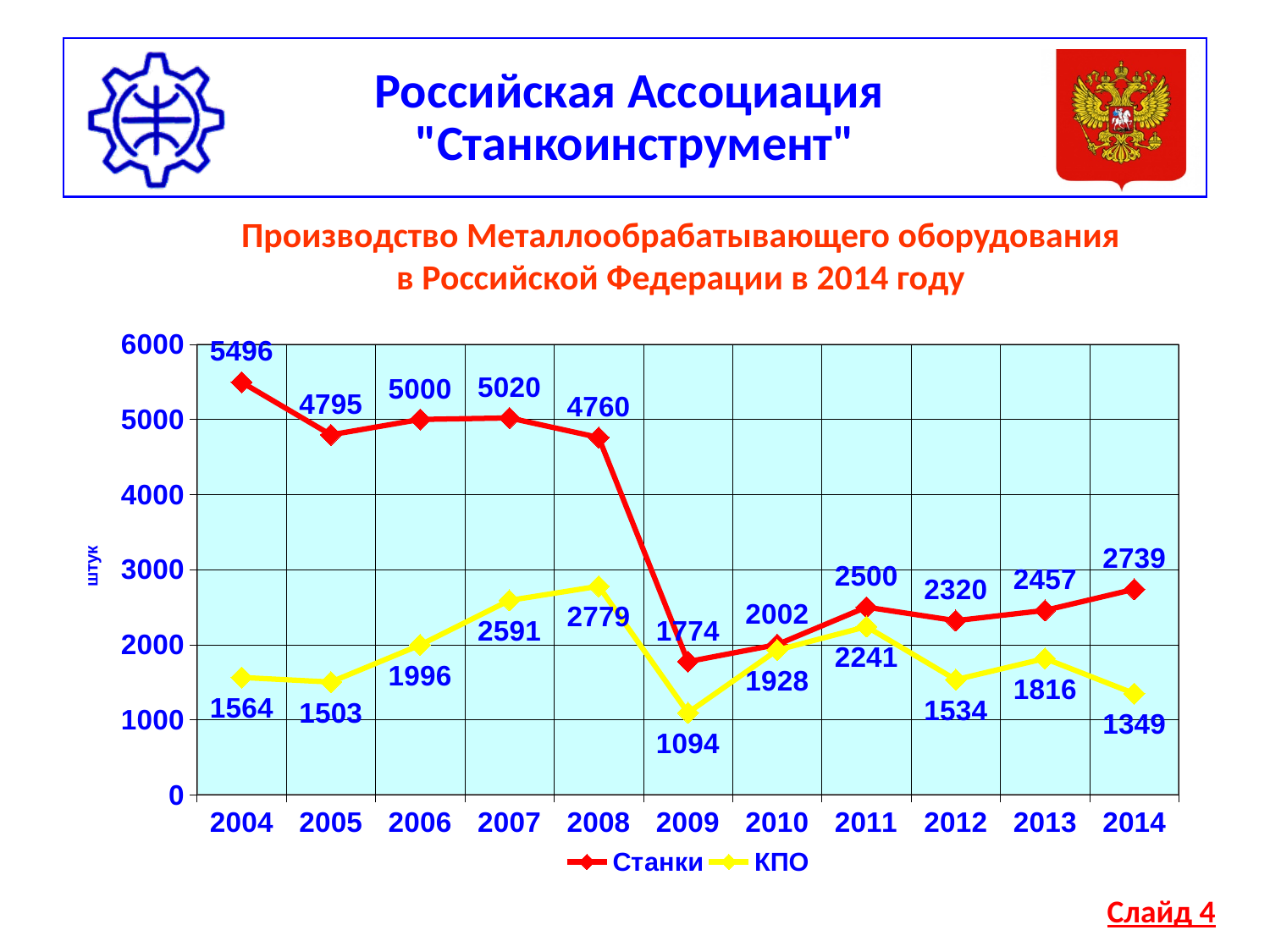
In which year is the КПО value lowest? 2009 What is the value for КПО in 2009? 1094 What is the label of the y axis? штук Does the Станки value rise or fall from 2004 to 2009? fall What type of chart is shown on the slide? line chart What is the value for Станки in 2004? 5496 In which year is the Станки value highest? 2004 How many years are shown on the x axis? 11 What is the difference between the Станки value in 2008 and in 2009? 2986 Which is larger in 2008: the Станки value or the КПО value? Станки What is the value for Станки in 2014? 2739 How many series does the legend list? 2